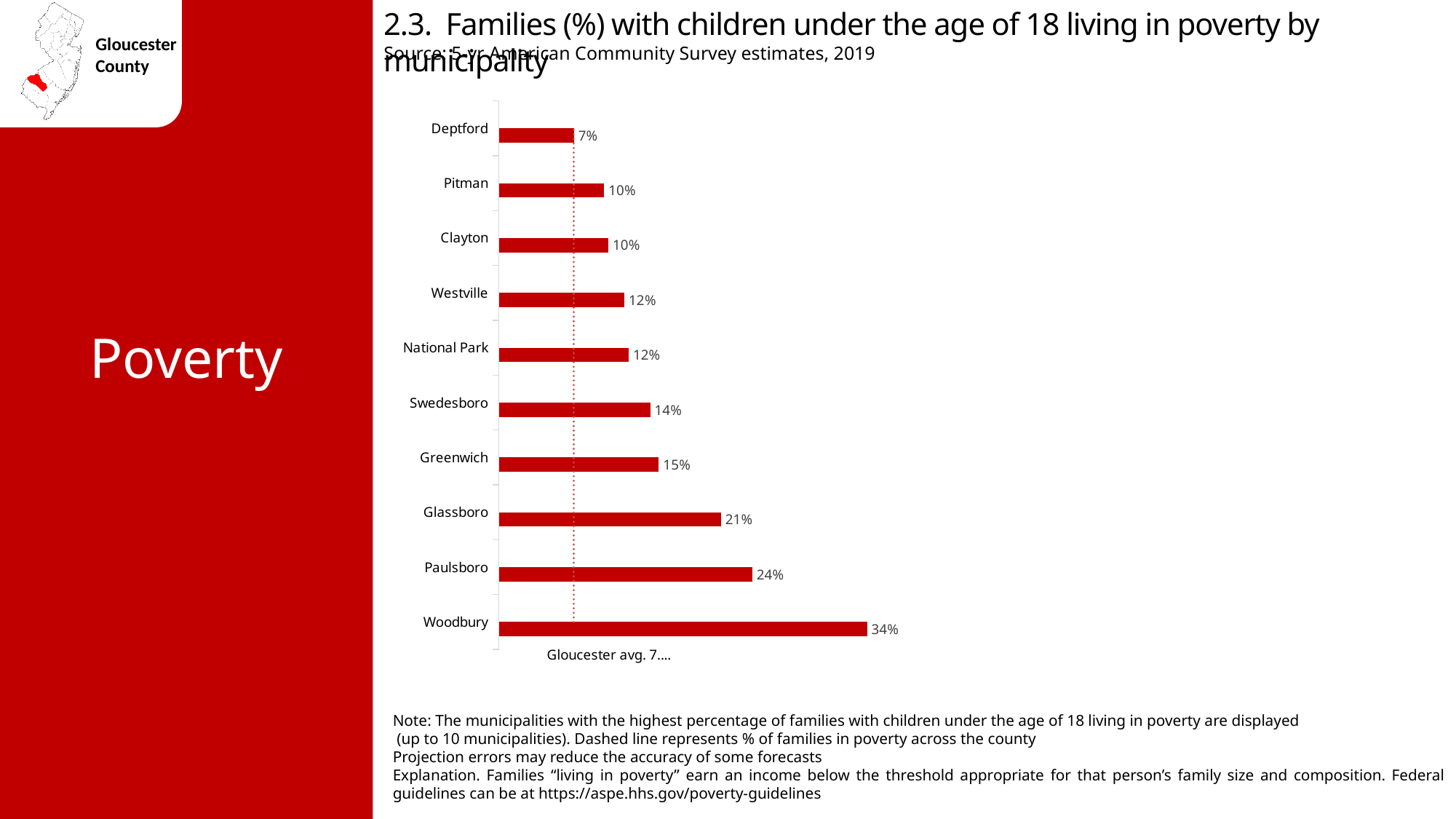
Which municipality has the lowest percentage shown on the chart? Deptford Which municipality has the highest percentage of families with children under 18 living in poverty? Woodbury How many municipalities are shown on the chart? 10 What percentage of families with children under 18 are living in poverty in Woodbury? 34% What is the source of the data shown in the chart? 5-yr American Community Survey estimates, 2019 What is the difference between the values for Woodbury and Paulsboro? 10% What type of chart is shown on the slide? Bar chart What is the difference between the values for Glassboro and Greenwich? 6% What does the dashed vertical line on the chart represent? Gloucester County average (% of families in poverty across the county) What is the value shown for Swedesboro? 14% What is the value shown for Paulsboro? 24% Which has a higher value, Glassboro or Westville? Glassboro